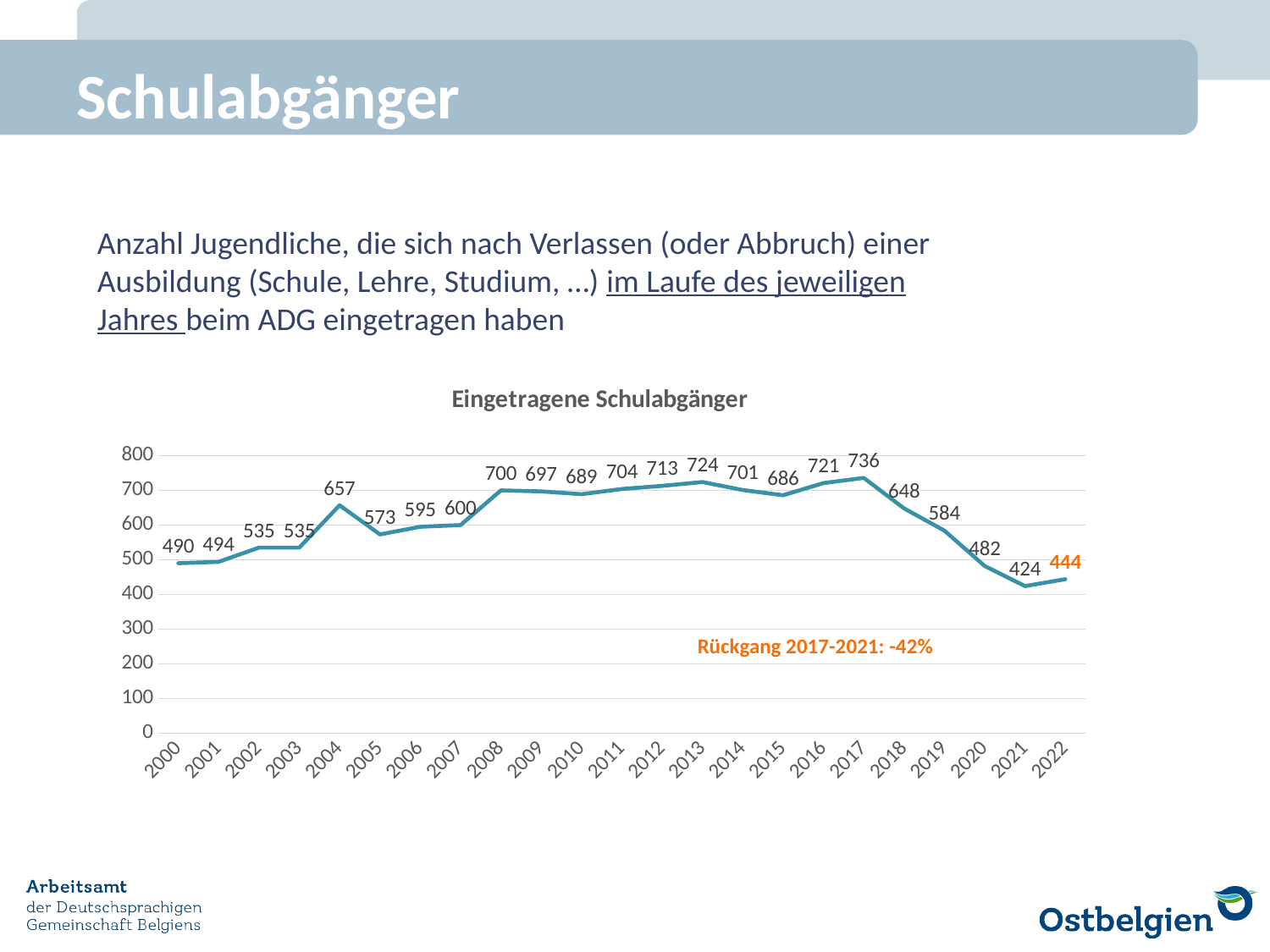
How many years are plotted in the chart 'Eingetragene Schulabgänger'? 23 Which is larger in the chart 'Eingetragene Schulabgänger': the value for 2013 or the value for 2016? 2013 Which year has the highest value in the chart 'Eingetragene Schulabgänger'? 2017 What is the value for 2004 in the chart 'Eingetragene Schulabgänger'? 657 Do the values in the chart 'Eingetragene Schulabgänger' rise or fall from 2017 to 2021? fall What kind of chart is 'Eingetragene Schulabgänger'? line chart What is the value for 2017 in the chart 'Eingetragene Schulabgänger'? 736 What is the difference between the values for 2017 and 2021 in the chart 'Eingetragene Schulabgänger'? 312 What percentage decline from 2017 to 2021 is annotated on the chart 'Eingetragene Schulabgänger'? -42% What is the value for 2022 in the chart 'Eingetragene Schulabgänger'? 444 Which year has the lowest value in the chart 'Eingetragene Schulabgänger'? 2021 Is the value for 2019 in the chart 'Eingetragene Schulabgänger' greater or less than 500? greater